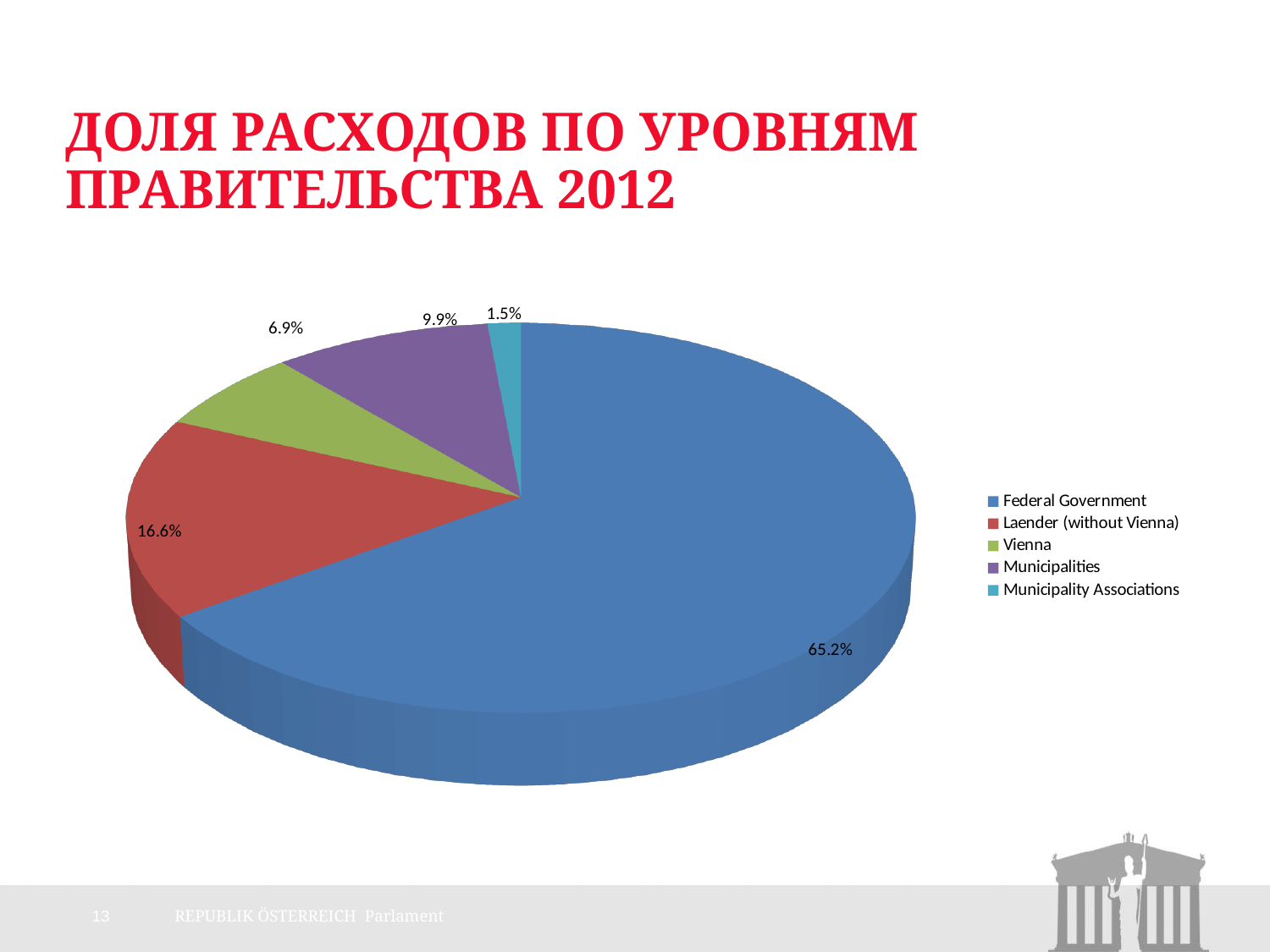
Which level of government has the largest share of expenditure? Federal Government What is the difference in percentage points between the Federal Government share and the Laender (without Vienna) share? 48.6 Which colour represents Vienna in the legend? Green What type of chart is shown on the slide? Pie chart What share of expenditure is attributed to Laender (without Vienna)? 16.6% What share of expenditure does Vienna account for? 6.9% What share of expenditure is attributed to Municipality Associations? 1.5% Which has a larger share of expenditure, Vienna or Municipalities? Municipalities What share of expenditure does the Federal Government account for? 65.2% What share of expenditure is attributed to Municipalities? 9.9% How many slices does the pie chart have? 5 Which level of government has the smallest share of expenditure? Municipality Associations